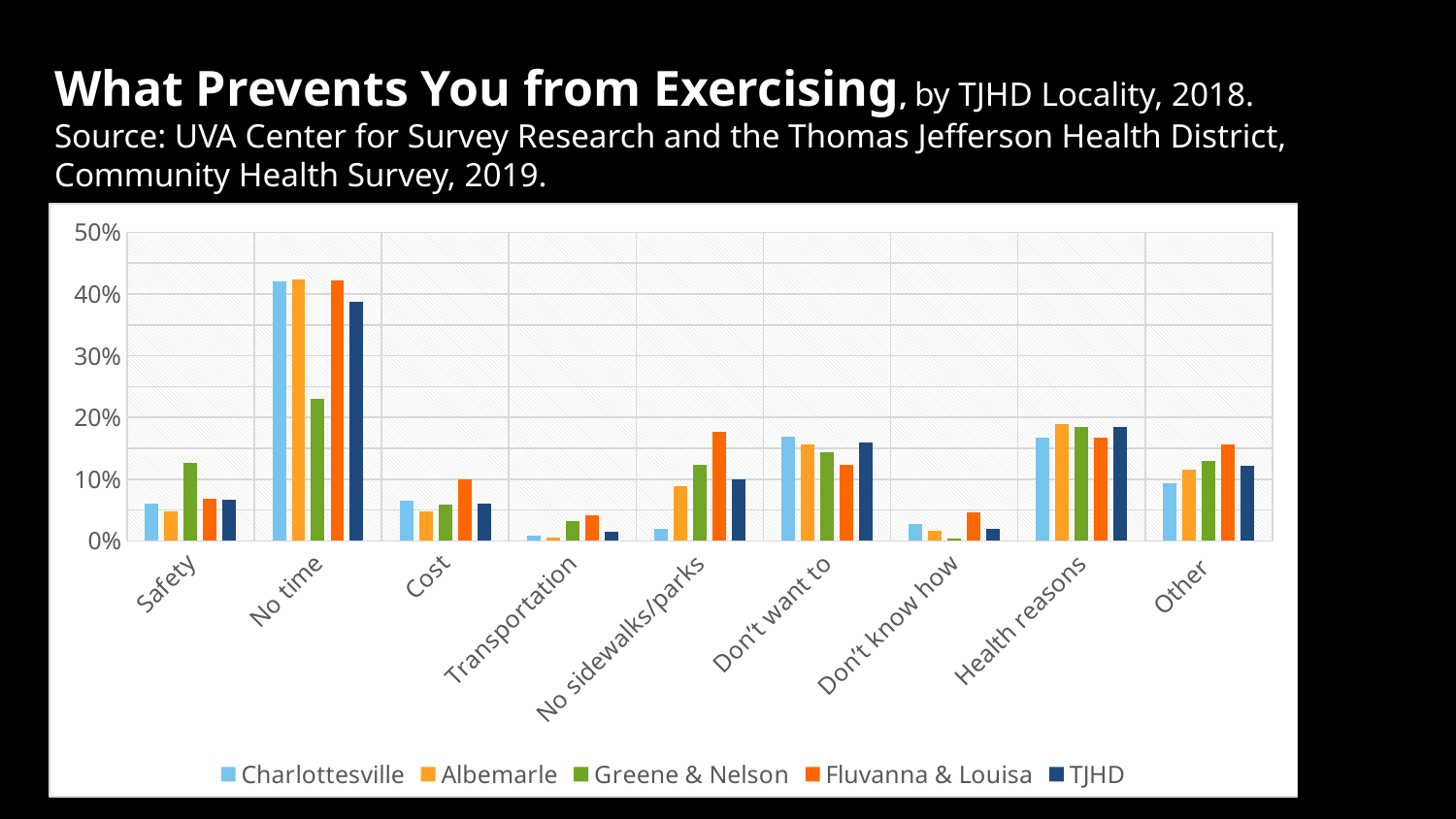
Within the Safety category, which locality has the highest bar? Greene & Nelson Is the Fluvanna & Louisa value for No sidewalks/parks greater or less than 10%? greater How many categories (reasons) are shown on the x axis? 9 For Greene & Nelson, which reason has the lowest value? Don't know how For No time, which is larger: the Albemarle value or the Greene & Nelson value? Albemarle How many series does the legend list? 5 What kind of chart is shown on the slide? bar chart Which locality is shown in the darkest blue bars according to the legend? TJHD Which reason has the highest value for every locality? No time Is the Charlottesville value for Cost greater or less than 10%? less Within the No sidewalks/parks category, which locality has the highest bar? Fluvanna & Louisa Is the Greene & Nelson value for No time greater or less than 20%? greater